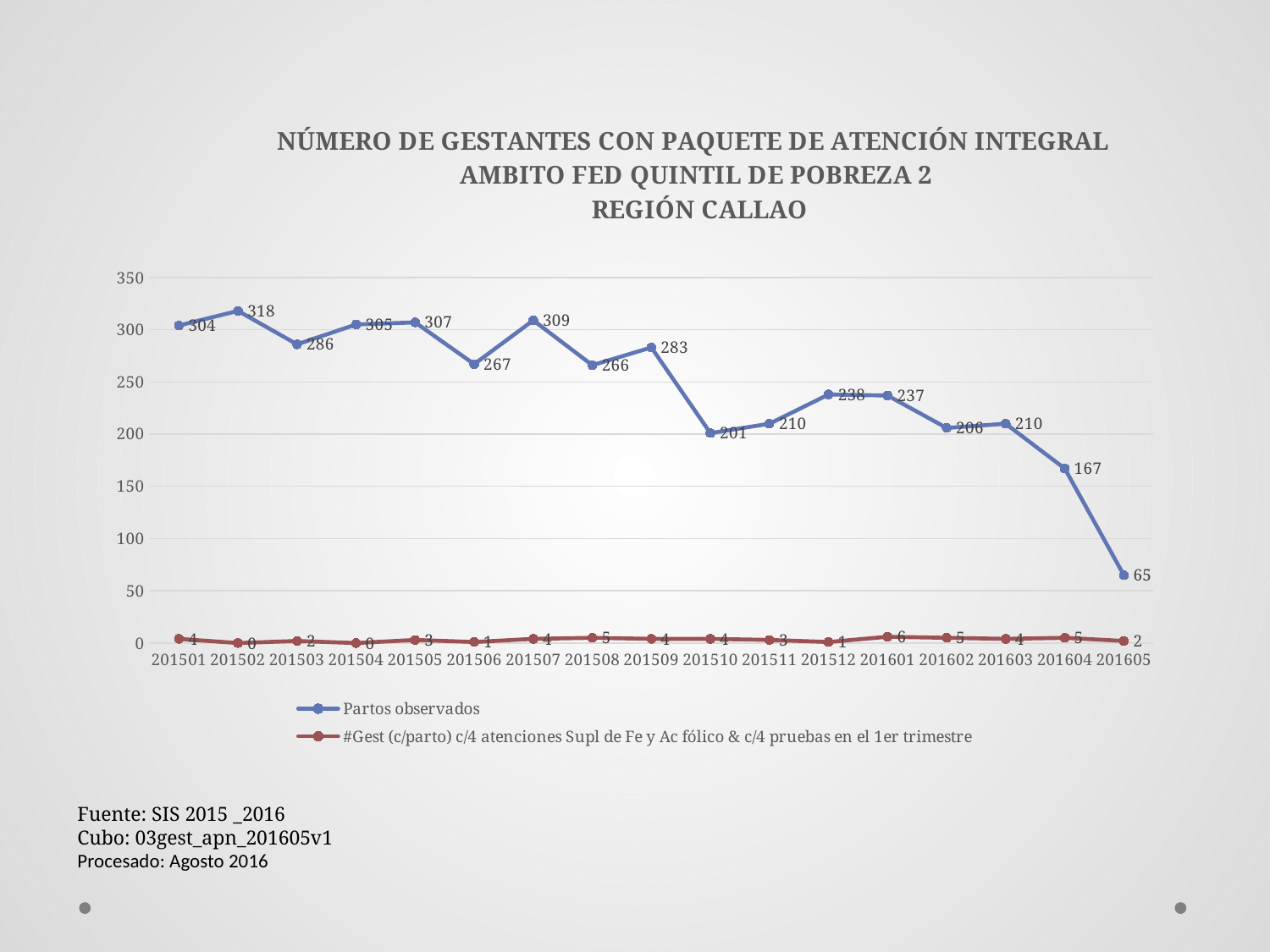
How many periods are shown on the x axis? 17 What is the value of Partos observados for 201605? 65 In which period is Partos observados lowest? 201605 Is the value of Partos observados for 201510 greater or less than 250? less What kind of chart is shown on the slide? Line chart What is the difference between Partos observados in 201604 and 201605? 102 In which period is Partos observados highest? 201502 Which period has a higher value of Partos observados, 201507 or 201509? 201507 What is the value of Partos observados for 201502? 318 How many series does the legend list? 2 Does Partos observados generally rise or fall from 201501 to 201605? Fall What is the value of the #Gest (c/parto) series for 201601? 6